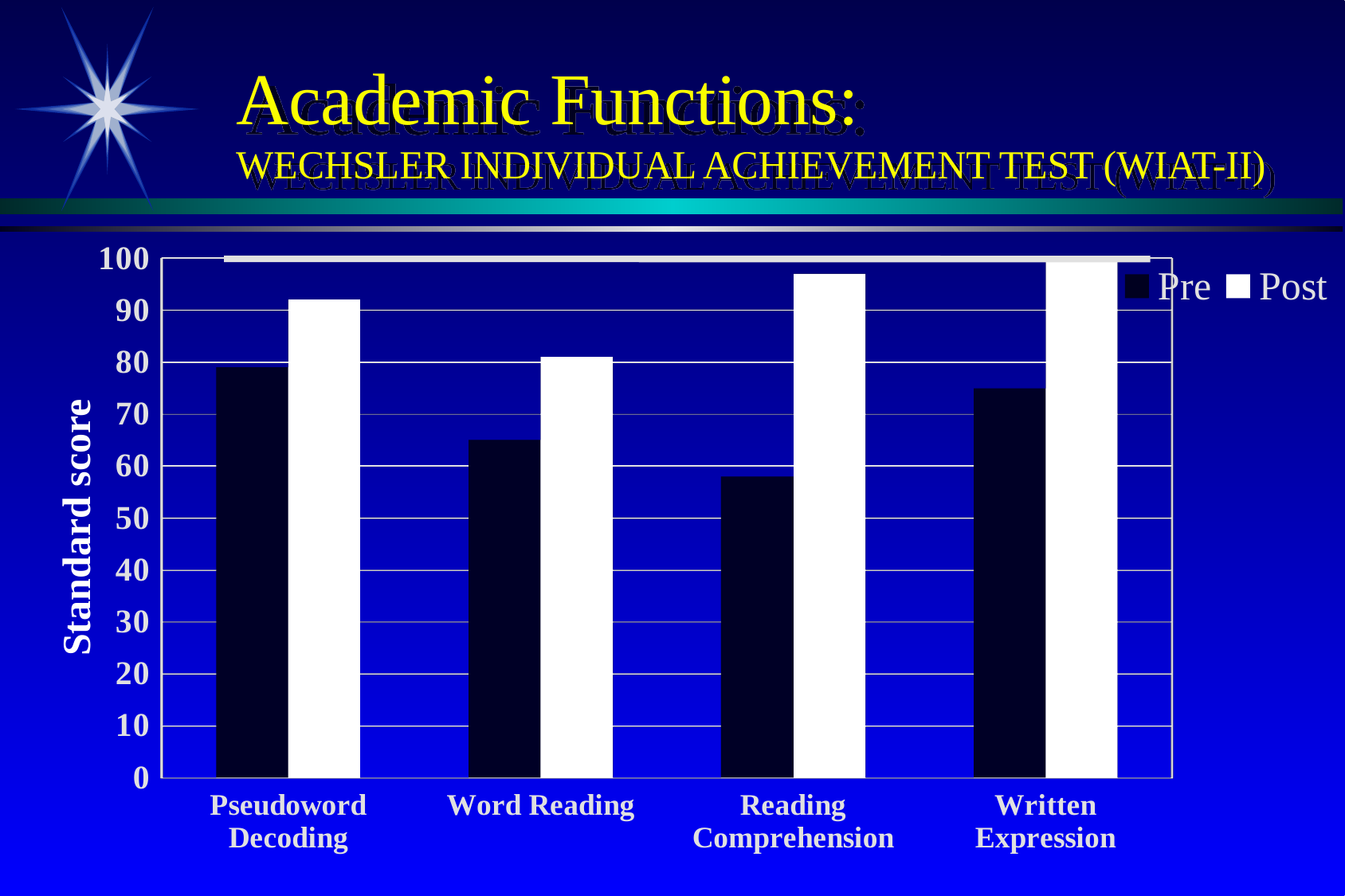
What kind of chart is shown on the slide? bar chart Is the Pre value for Reading Comprehension greater or less than 60? less Which category has the highest Post value? Written Expression How many categories are shown on the x axis? 4 Which category has the lowest Pre value? Reading Comprehension Which category has the lowest Post value? Word Reading Which category has the highest Pre value? Pseudoword Decoding How many series does the legend list? 2 Is the Post value for Reading Comprehension greater or less than 90? greater Which is larger for Word Reading, the Pre value or the Post value? Post Is the Pre value for Word Reading greater or less than 70? less What is the label on the vertical axis? Standard score